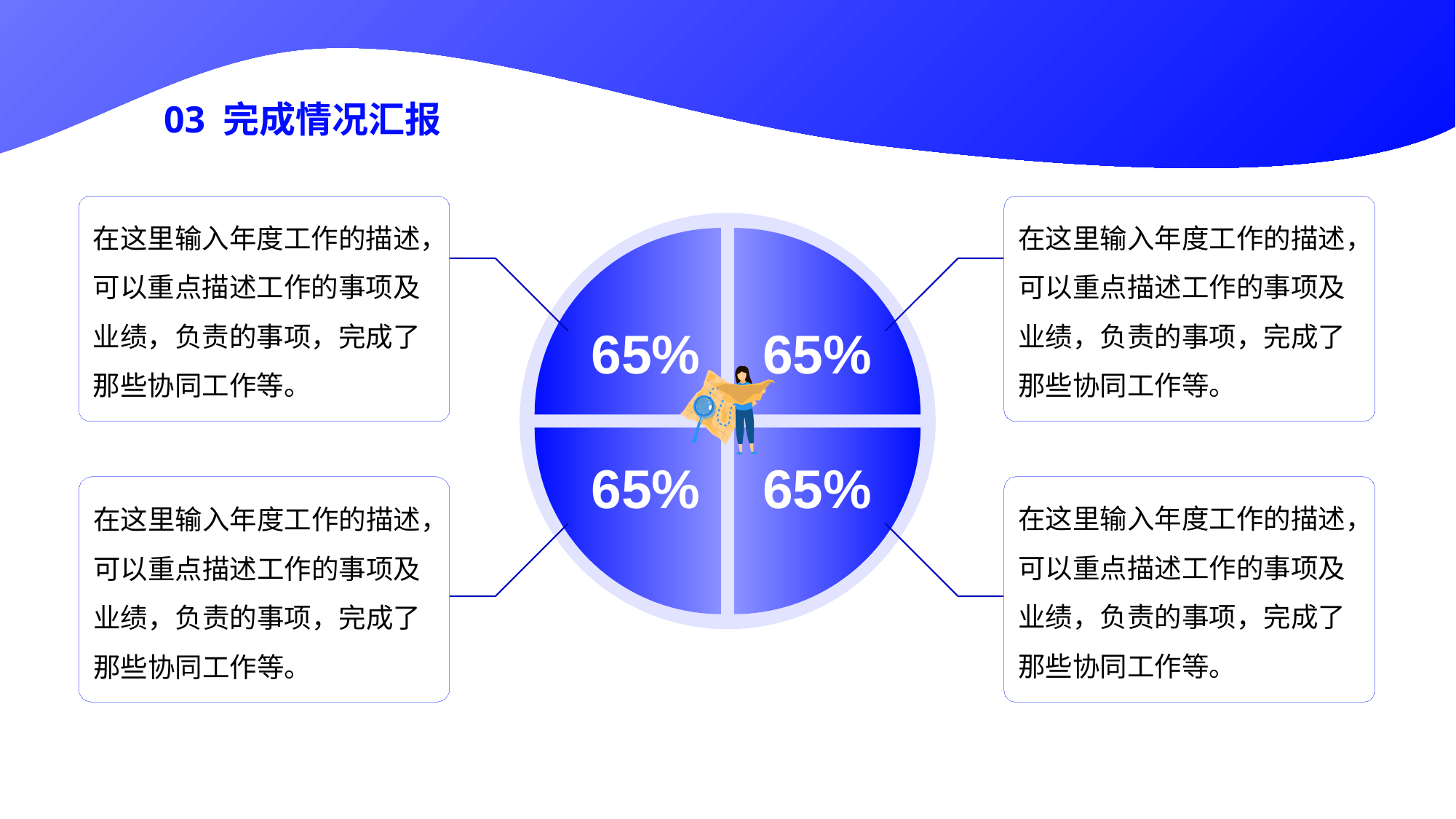
What value is printed in the bottom-right segment of the circular chart? 65% What is the difference between the values in the top-left and bottom-right segments? 0% What value is printed in the bottom-left segment of the circular chart? 65% How many segments does the circular chart have? 4 What value is printed in the top-right segment of the circular chart? 65% Is the value in the top-left segment greater or less than 50%? greater What value is printed in the top-left segment of the circular chart? 65% What kind of chart is shown in the centre of the slide? pie chart What colour are the four segments of the circular chart? blue Do all four segments of the circular chart show the same value? Yes What is the section title shown at the top of the slide? 03 完成情况汇报